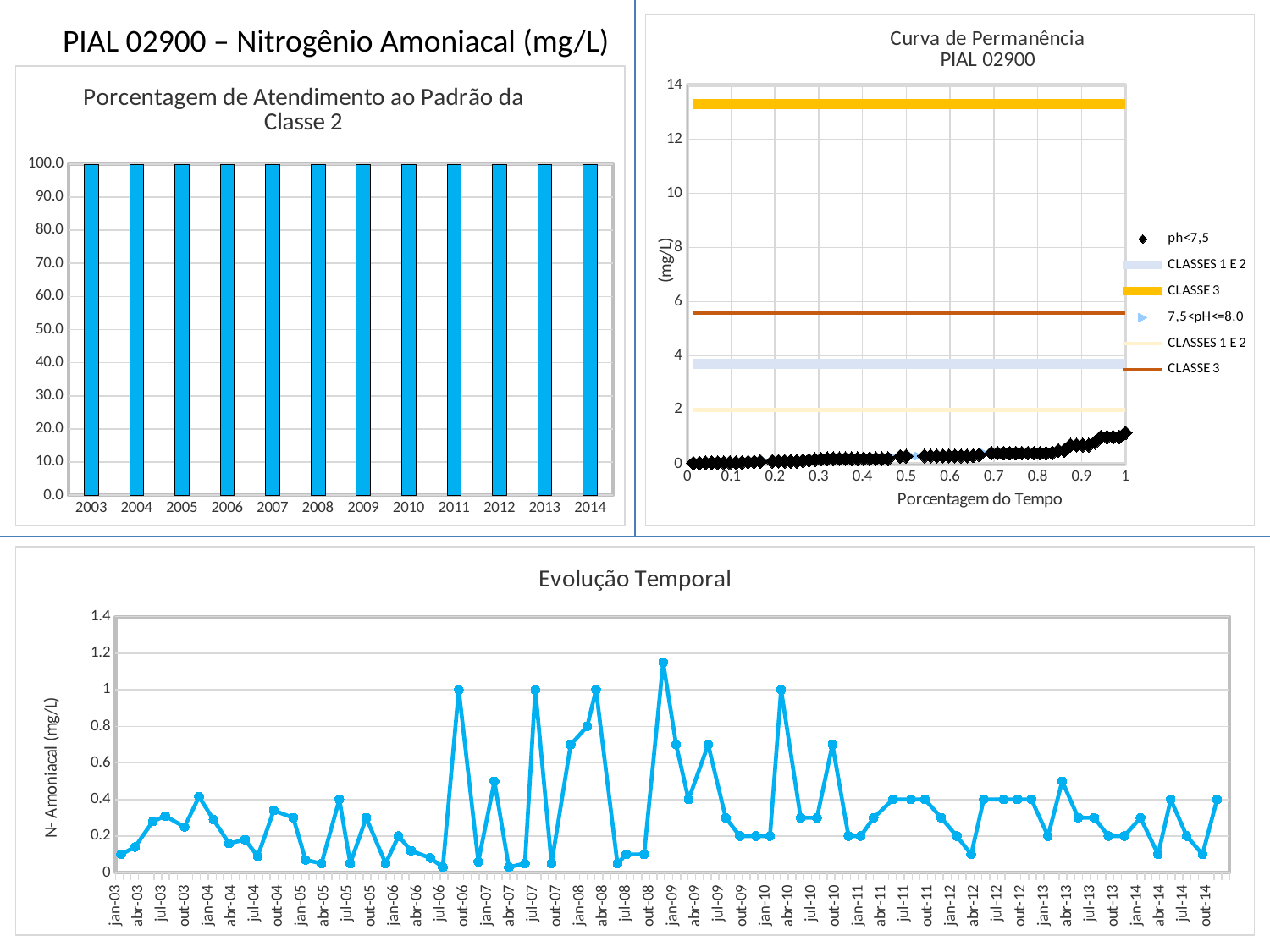
In the 'Curva de Permanência PIAL 02900' chart, is the brown CLASSE 3 line greater or less than 4? greater How many entries does the legend of the 'Curva de Permanência PIAL 02900' chart list? 6 What is the x-axis title of the 'Curva de Permanência PIAL 02900' chart? Porcentagem do Tempo In the 'Evolução Temporal' chart, which is larger, the value for jan-09 or the value for jan-03? jan-09 In the 'Porcentagem de Atendimento ao Padrão da Classe 2' chart, what is the value for 2014? 100.0 In the 'Curva de Permanência PIAL 02900' chart, is the yellow CLASSE 3 line greater or less than 12? greater What kind of chart is the 'Porcentagem de Atendimento ao Padrão da Classe 2' chart on the left? bar chart What kind of chart is the 'Evolução Temporal' chart at the bottom of the slide? line chart In the 'Porcentagem de Atendimento ao Padrão da Classe 2' chart, what is the first year shown on the x axis? 2003 How many years are shown on the x axis of the 'Porcentagem de Atendimento ao Padrão da Classe 2' chart? 12 In the 'Porcentagem de Atendimento ao Padrão da Classe 2' chart, what is the value for 2003? 100.0